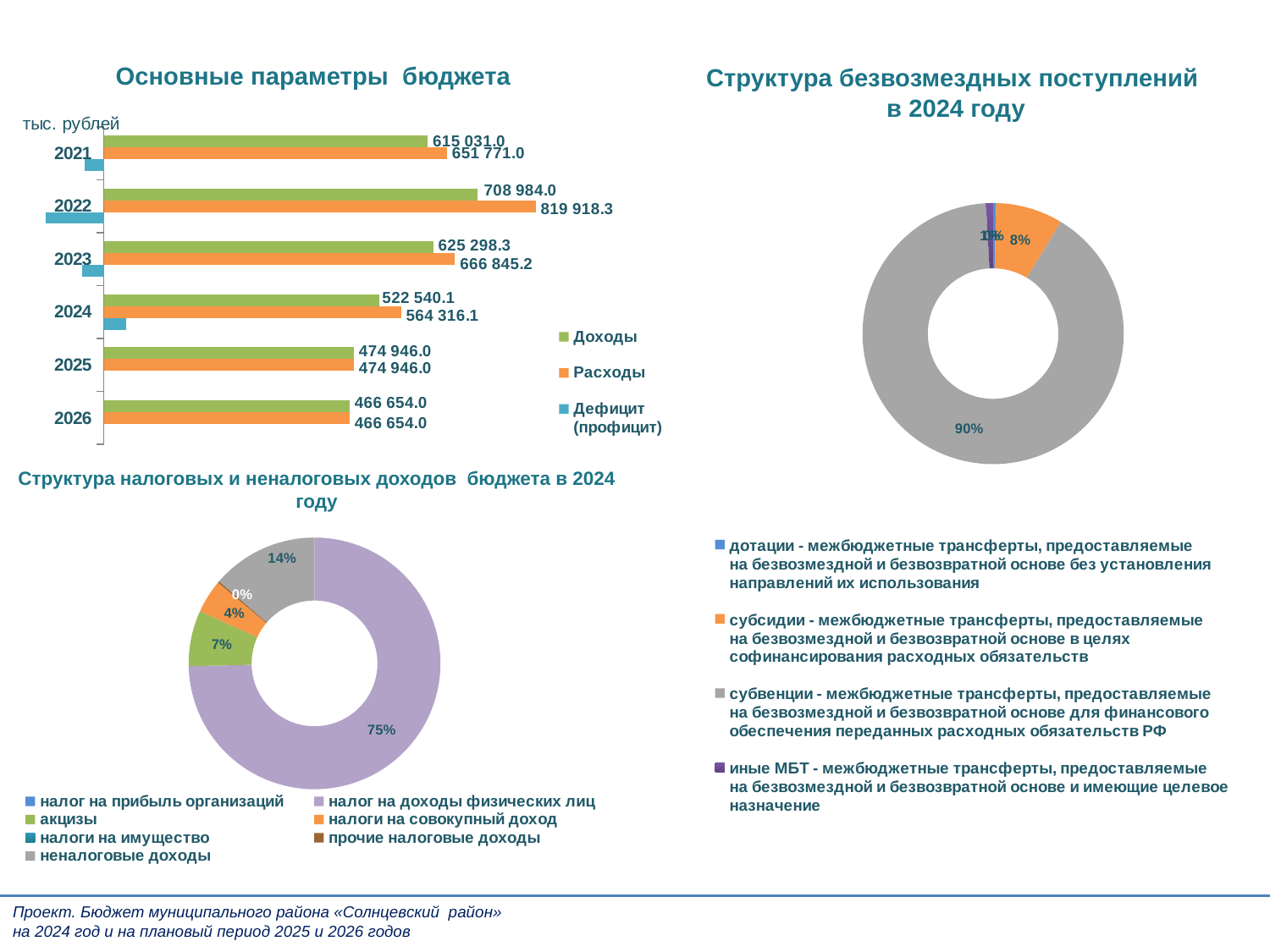
In the chart 'Структура безвозмездных поступлений в 2024 году', which category has the largest share? субвенции In the chart 'Основные параметры бюджета', what is the value of Расходы for 2024? 564 316.1 In the chart 'Основные параметры бюджета', what is the difference between Расходы and Доходы in 2024? 41 776.0 In the chart 'Структура налоговых и неналоговых доходов бюджета в 2024 году', what share does налог на доходы физических лиц have? 75% In the chart 'Основные параметры бюджета', which year has the highest Расходы? 2022 In the chart 'Основные параметры бюджета', what is the value of Доходы for 2022? 708 984.0 In the chart 'Основные параметры бюджета', how many series does the legend list? 3 In the chart 'Основные параметры бюджета', how many years are shown? 6 In the chart 'Основные параметры бюджета', which year has the lowest Доходы? 2026 What kind of chart is 'Основные параметры бюджета'? Bar chart In the chart 'Основные параметры бюджета', which is larger in 2023: Доходы or Расходы? Расходы In the chart 'Структура безвозмездных поступлений в 2024 году', what share do субсидии have? 8%